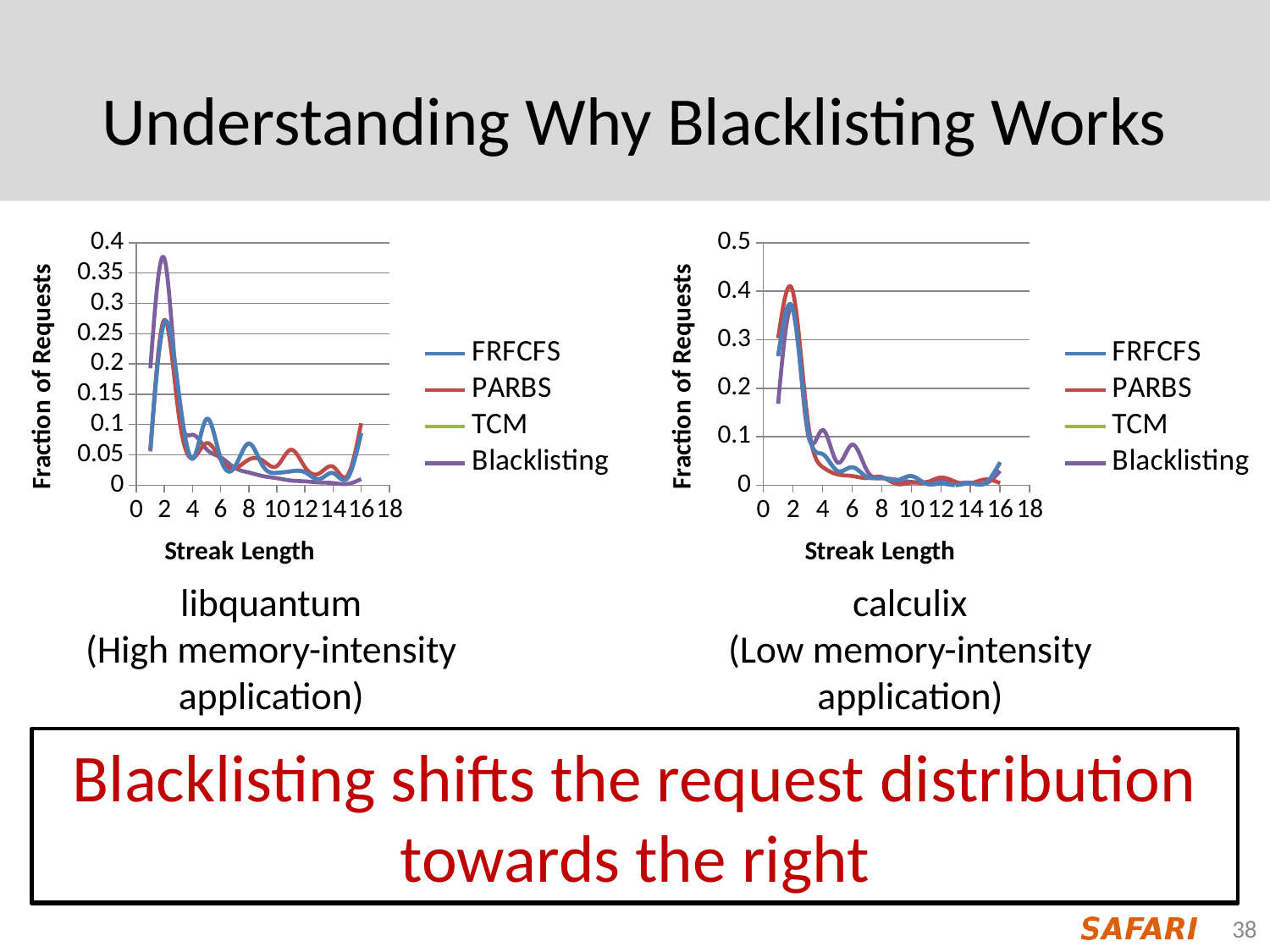
What kind of chart is the libquantum chart on the left? line chart What is the label of the x axis on the libquantum chart on the left? Streak Length In the libquantum chart on the left, is the peak value of the Blacklisting series greater or less than 0.3? greater In the calculix chart on the right, which series has the higher peak, PARBS or FRFCFS? PARBS In the libquantum chart on the left, after the peak near streak length 2, do the values generally rise or fall as streak length increases? fall What kind of chart is the calculix chart on the right? line chart In the libquantum chart on the left, which series reaches the highest peak? Blacklisting In the libquantum chart on the left, is the peak value of the FRFCFS series greater or less than 0.3? less How many series does the legend of the calculix chart on the right list? 4 In the calculix chart on the right, is the peak value of the FRFCFS series greater or less than 0.4? less What is the label of the y axis on the calculix chart on the right? Fraction of Requests